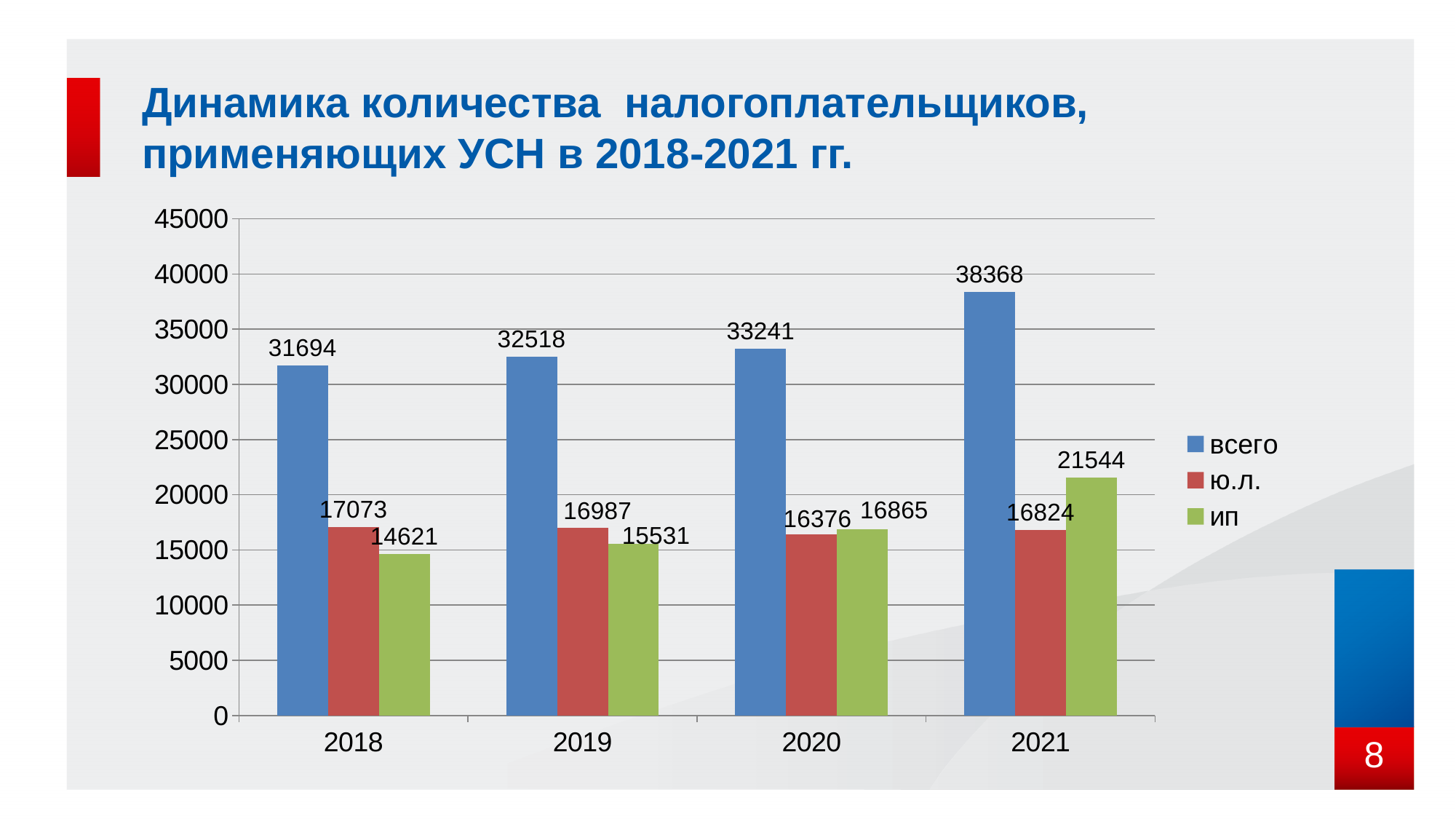
Does the "всего" series rise or fall from 2018 to 2021? rise In which year is the "всего" value the highest? 2021 How many series does the legend list? 3 What kind of chart is shown on the slide? bar chart Which is larger in 2021: the "ю.л." value or the "ип" value? ип What is the value of the "ю.л." series for 2020? 16376 What is the difference between the "всего" values for 2021 and 2018? 6674 In which year is the "ип" value the lowest? 2018 What is the value of the "ип" series for 2018? 14621 Is the "всего" value for 2020 greater or less than 30000? greater What is the value of the "всего" series for 2021? 38368 How many years are shown on the x axis? 4